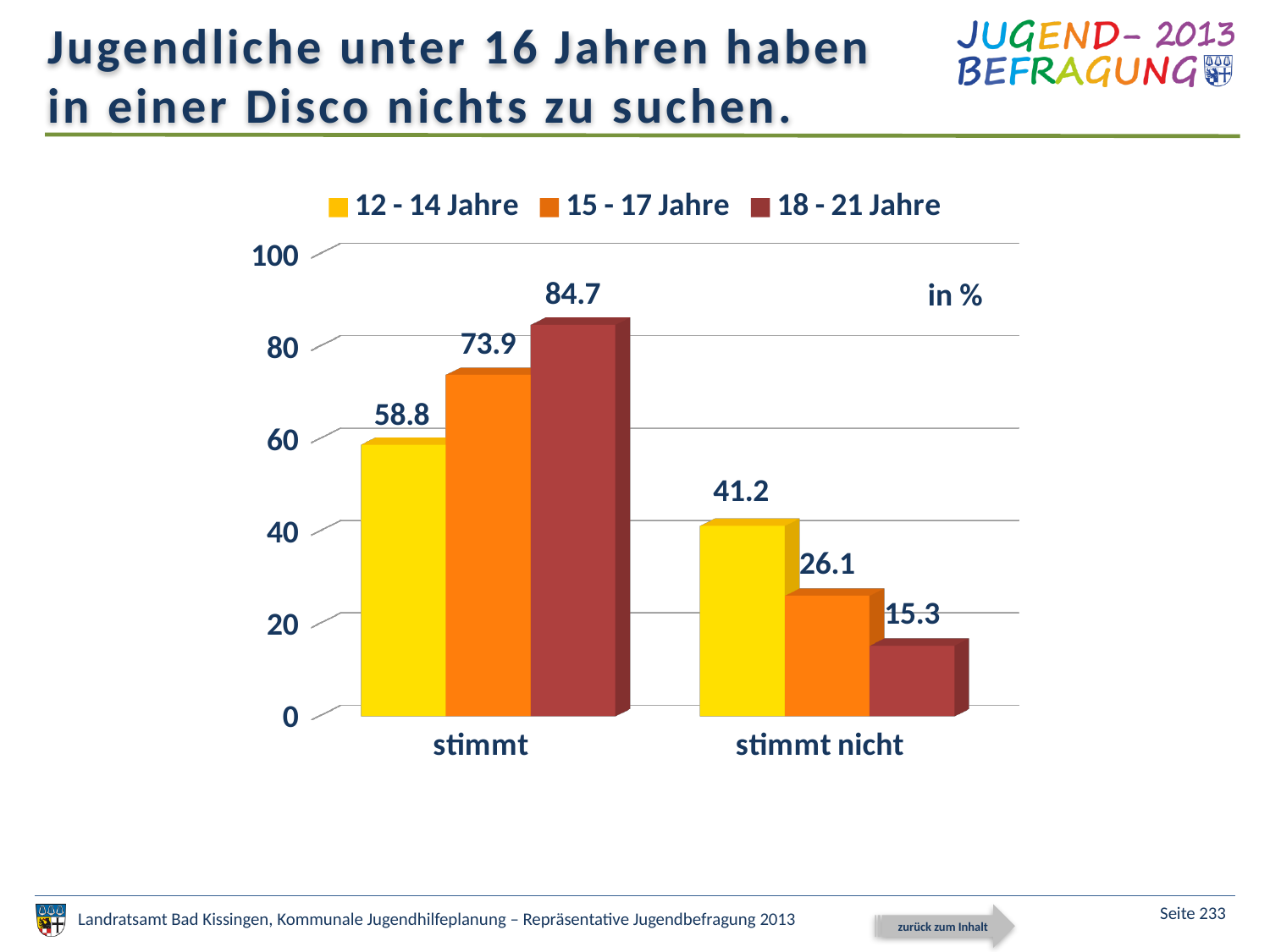
What is the value for the 15 - 17 Jahre series in the "stimmt" category? 73.9 Is the value for 12 - 14 Jahre in the "stimmt nicht" category greater or less than 40? greater Which age group has the highest value in the "stimmt" category? 18 - 21 Jahre Which is larger: the 15 - 17 Jahre value for "stimmt" or the 15 - 17 Jahre value for "stimmt nicht"? stimmt How many series does the legend list? 3 How many categories are shown on the x axis? 2 What is the difference between the 12 - 14 Jahre and 15 - 17 Jahre values in the "stimmt nicht" category? 15.1 What is the value for the 18 - 21 Jahre series in the "stimmt nicht" category? 15.3 What is the difference between the 18 - 21 Jahre and 12 - 14 Jahre values in the "stimmt" category? 25.9 Which age group has the lowest value in the "stimmt nicht" category? 18 - 21 Jahre What is the value for the 12 - 14 Jahre series in the "stimmt" category? 58.8 What kind of chart is shown on the slide? bar chart